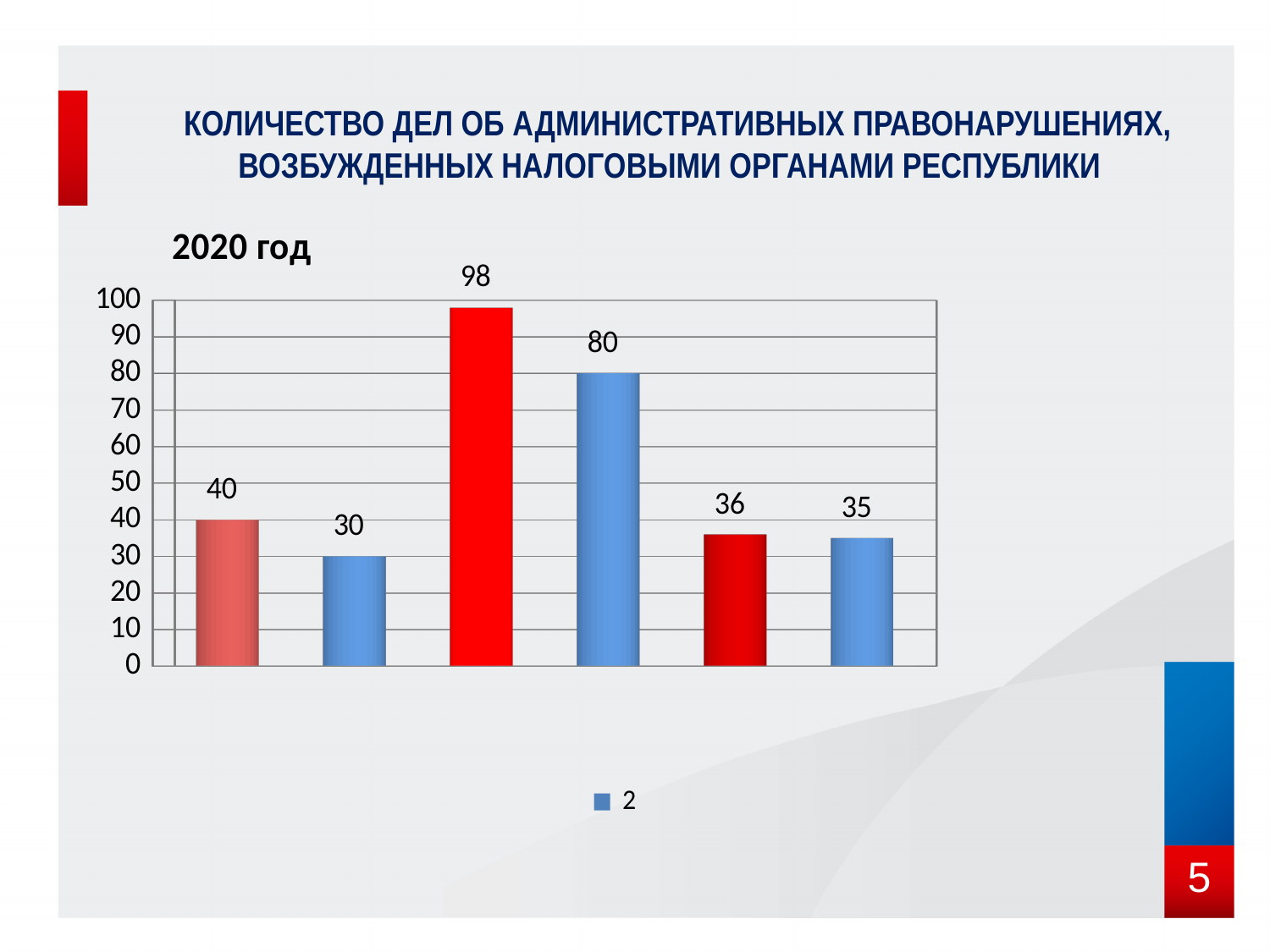
What is the value of the last (rightmost) bar in the chart? 35 How many bars are plotted in the chart? 6 What is the difference between the third bar (98) and the fourth bar (80)? 18 What is the value of the third bar from the left in the chart? 98 What type of chart is shown on the slide? Bar chart What is the highest value shown in the chart? 98 What year is shown as the chart's subtitle? 2020 год What is the value of the fourth bar from the left in the chart? 80 What is the lowest value shown in the chart? 30 Which is larger, the value of the first bar or the value of the fifth bar? The first bar (40) What is the difference between the first bar (40) and the second bar (30)? 10 What is the value of the first (leftmost) bar in the chart? 40